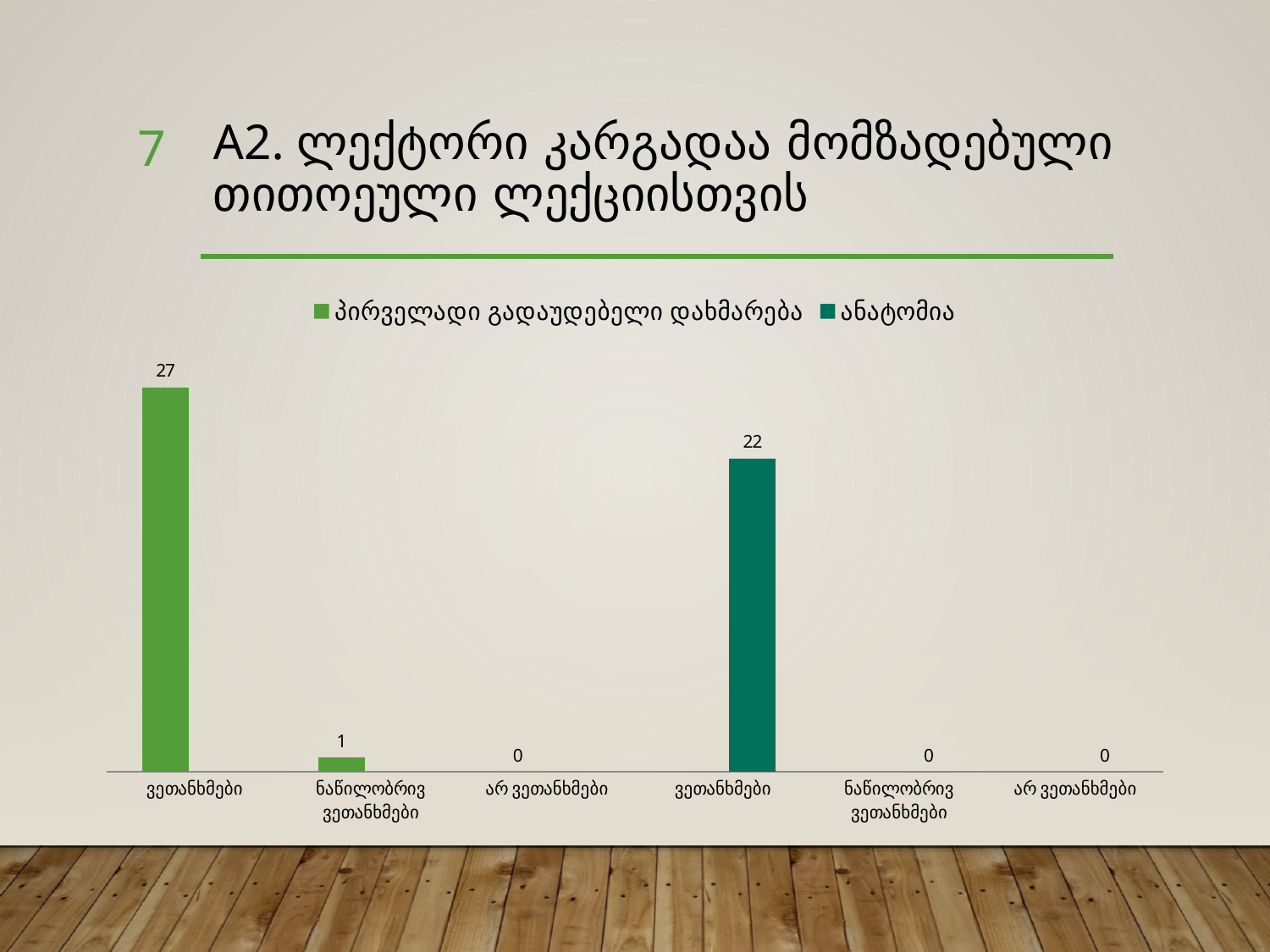
Which bar has the highest value in the chart? ვეთანხმები (პირველადი გადაუდებელი დახმარება) What is the total of the three values for the 'პირველადი გადაუდებელი დახმარება' series? 28 What colour are the bars of the 'ანატომია' series? dark teal green What is the value of the 'ვეთანხმები' bar for the 'ანატომია' series? 22 What is the value of the 'ვეთანხმები' bar for the 'პირველადი გადაუდებელი დახმარება' series? 27 What is the difference between the 'ვეთანხმები' values of the two series? 5 What is the value of the 'ნაწილობრივ ვეთანხმები' bar for the 'პირველადი გადაუდებელი დახმარება' series? 1 Which is larger: the 'ვეთანხმები' value for 'პირველადი გადაუდებელი დახმარება' or for 'ანატომია'? პირველადი გადაუდებელი დახმარება How many series does the legend list? 2 What is the value of the 'არ ვეთანხმები' bar for the 'ანატომია' series? 0 What type of chart is shown on the slide? bar chart How many bars are plotted in the chart? 6